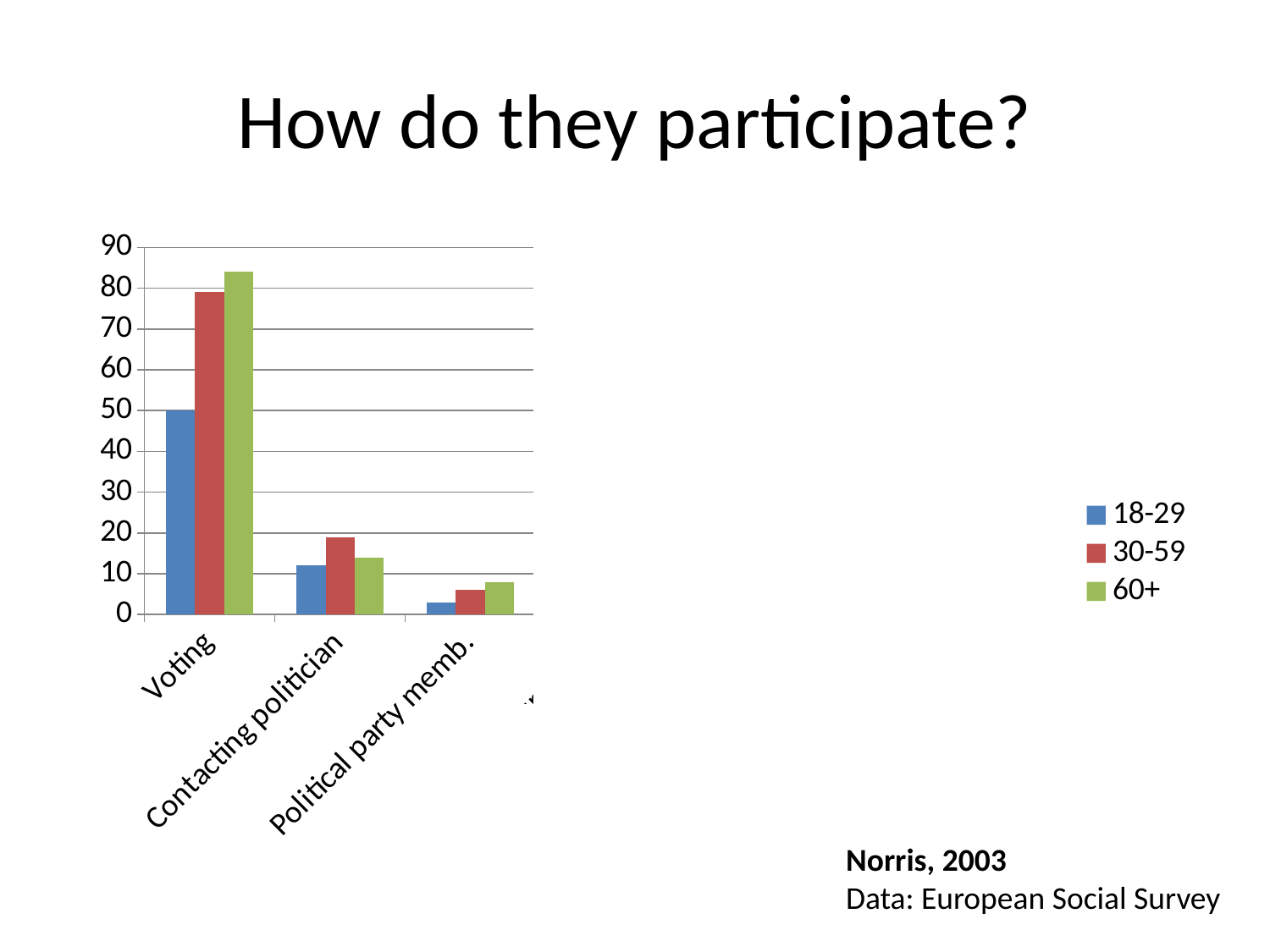
For Voting, which is larger: the value for 18-29 or for 30-59? 30-59 What is the title of the slide containing the chart? How do they participate? Is the Political party memb. value for 18-29 greater or less than 10? less Is the Contacting politician value for 30-59 greater or less than 10? greater Is the Voting value for 18-29 greater or less than 40? greater Which category has the highest values across all age groups? Voting For Political party memb., which age group has the lowest bar? 18-29 What kind of chart is shown on the slide? bar chart How many series does the legend list? 3 For Voting, which age group has the highest bar? 60+ For Contacting politician, which is larger: the value for 30-59 or for 60+? 30-59